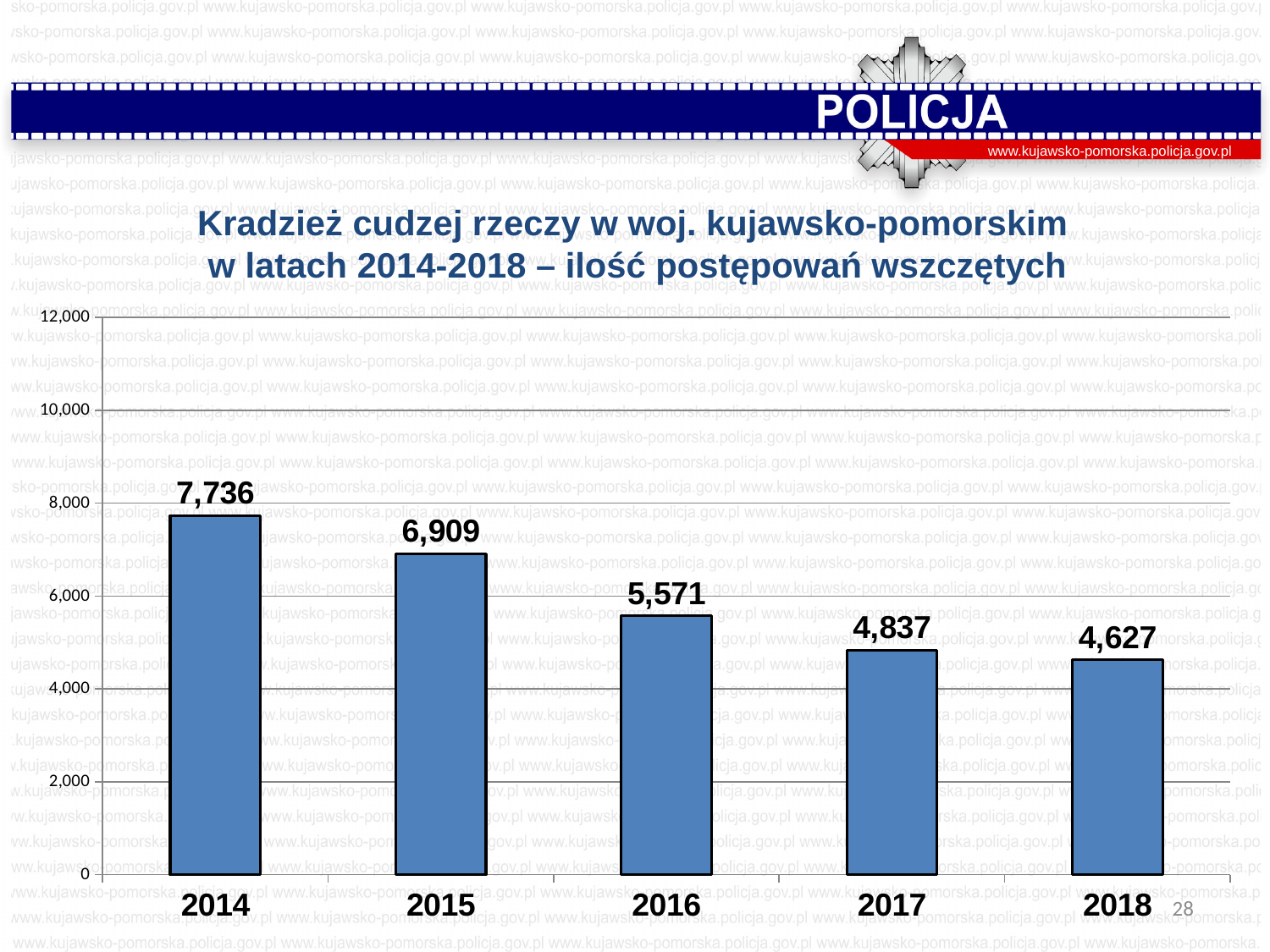
What is the value for 2014? 7,736 Which year has the highest value? 2014 What is the difference between the values for 2014 and 2015? 827 Which year has the lowest value? 2018 What is the difference between the values for 2017 and 2018? 210 How many years are shown on the chart? 5 Is the value for 2017 greater or less than 6,000? less Which is larger, the value for 2015 or the value for 2016? 2015 What is the value for 2016? 5,571 Do the values rise or fall from 2014 to 2018? fall What kind of chart is shown on the slide? bar chart What is the value for 2018? 4,627